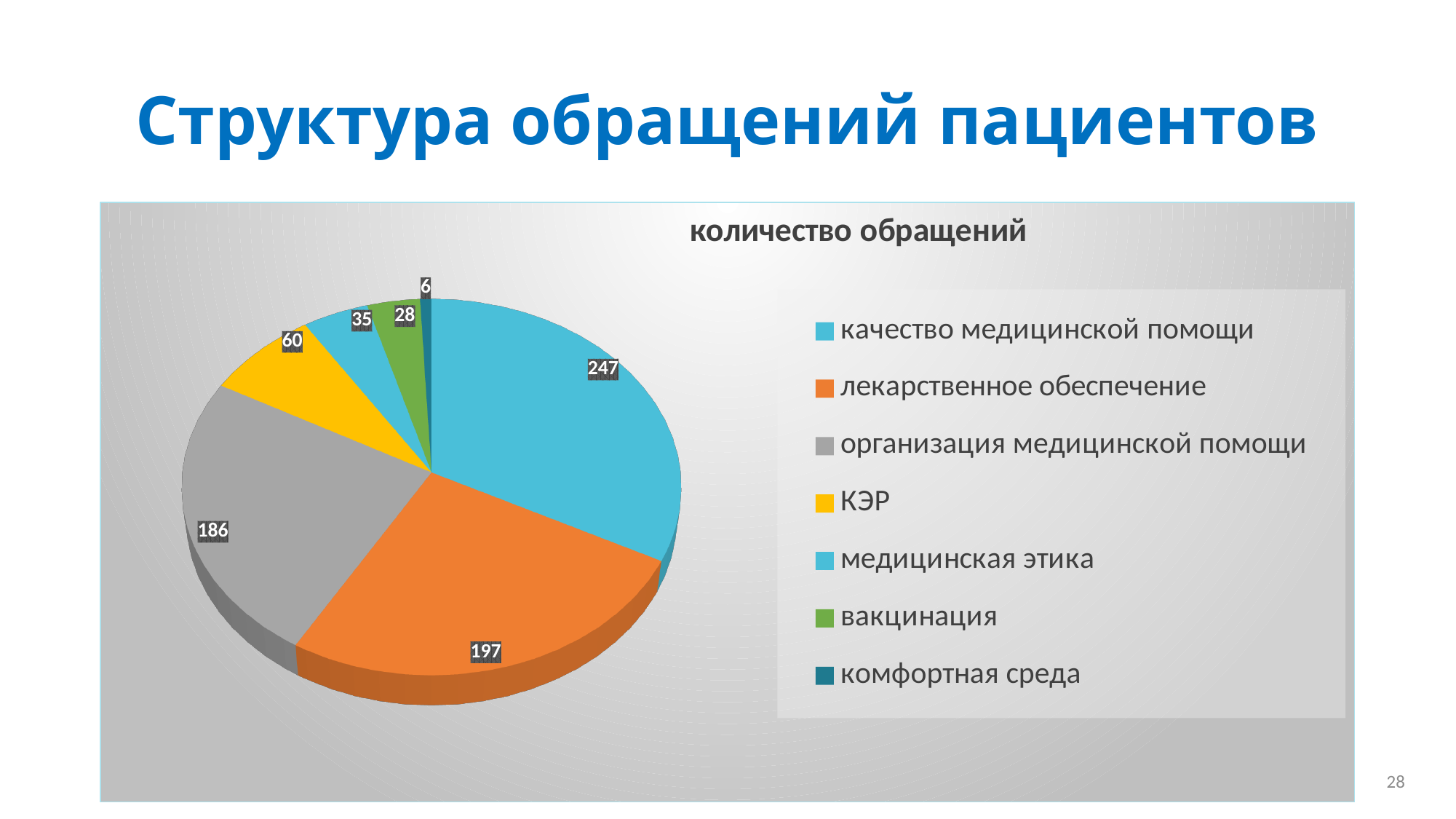
What is the value for лекарственное обеспечение? 197 What is the value for качество медицинской помощи? 247 What is the value for организация медицинской помощи? 186 What type of chart is shown on the slide? pie chart What is the title of the chart? количество обращений How many categories does the pie chart have? 7 What is the difference between the values for качество медицинской помощи and лекарственное обеспечение? 50 Which category has the largest slice? качество медицинской помощи Which is larger, the value for медицинская этика or the value for вакцинация? медицинская этика Which category has the smallest slice? комфортная среда What is the value for вакцинация? 28 What is the value for КЭР? 60